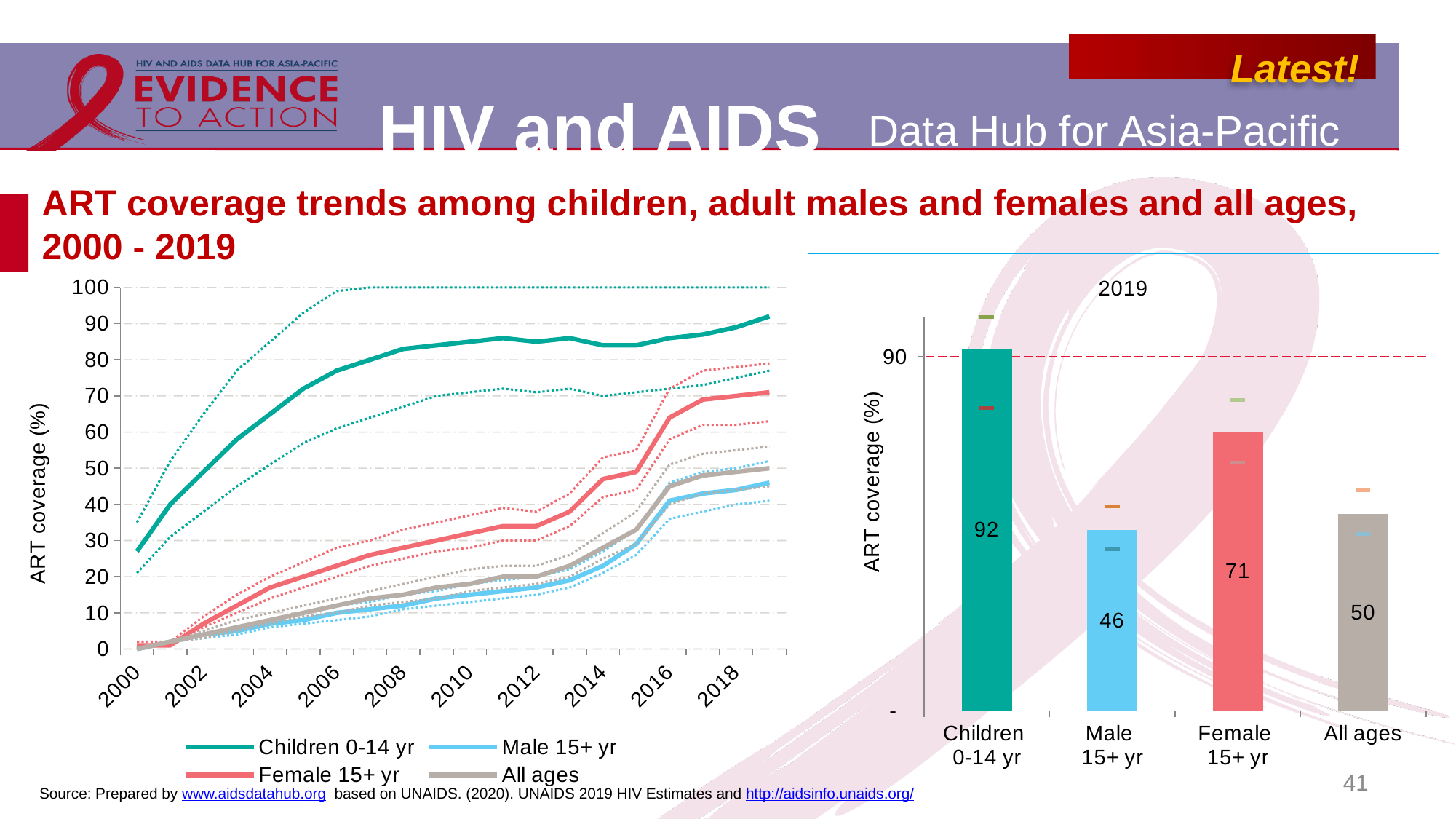
In the 2019 bar chart, what is the ART coverage for Male 15+ yr? 46 In the 2019 bar chart, which group has the lowest ART coverage? Male 15+ yr In the 2019 bar chart, which group has the highest ART coverage? Children 0-14 yr In the 2019 bar chart, is the ART coverage for All ages greater or less than 90? less What type of chart is the chart on the left of the slide? line chart In the left line chart, does the ART coverage for Children 0-14 yr rise or fall from 2000 to 2019? rise How many series does the legend of the left line chart list? 4 In the 2019 bar chart, what is the difference in ART coverage between Female 15+ yr and Male 15+ yr? 25 In the left line chart, is the ART coverage for Male 15+ yr in 2010 greater or less than 30? less In the 2019 bar chart, what is the ART coverage for Female 15+ yr? 71 In the 2019 bar chart, what is the ART coverage for Children 0-14 yr? 92 How many categories are shown in the 2019 bar chart? 4